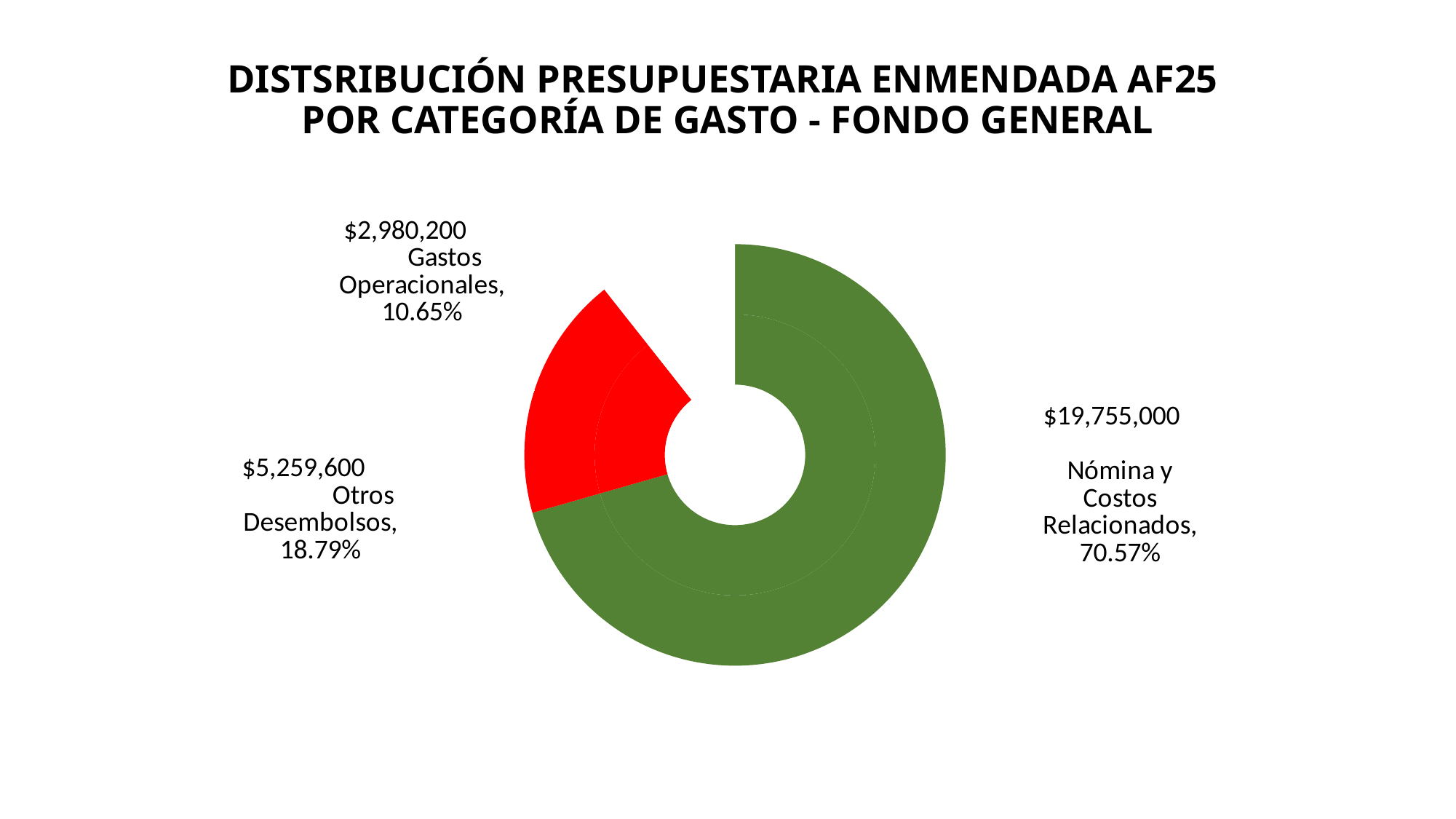
Which is larger, Otros Desembolsos or Gastos Operacionales? Otros Desembolsos Which category has the largest value? Nómina y Costos Relacionados What share of the chart does Otros Desembolsos represent? 18.79% What share of the chart does Nómina y Costos Relacionados represent? 70.57% What is the value for Nómina y Costos Relacionados? $19,755,000 How many categories are shown in the chart? 3 What is the value for Gastos Operacionales? $2,980,200 Which category has the smallest value? Gastos Operacionales What share of the chart does Gastos Operacionales represent? 10.65% What is the difference between the values for Otros Desembolsos and Gastos Operacionales? $2,279,400 What is the value for Otros Desembolsos? $5,259,600 What kind of chart is shown on the slide? Doughnut (pie) chart